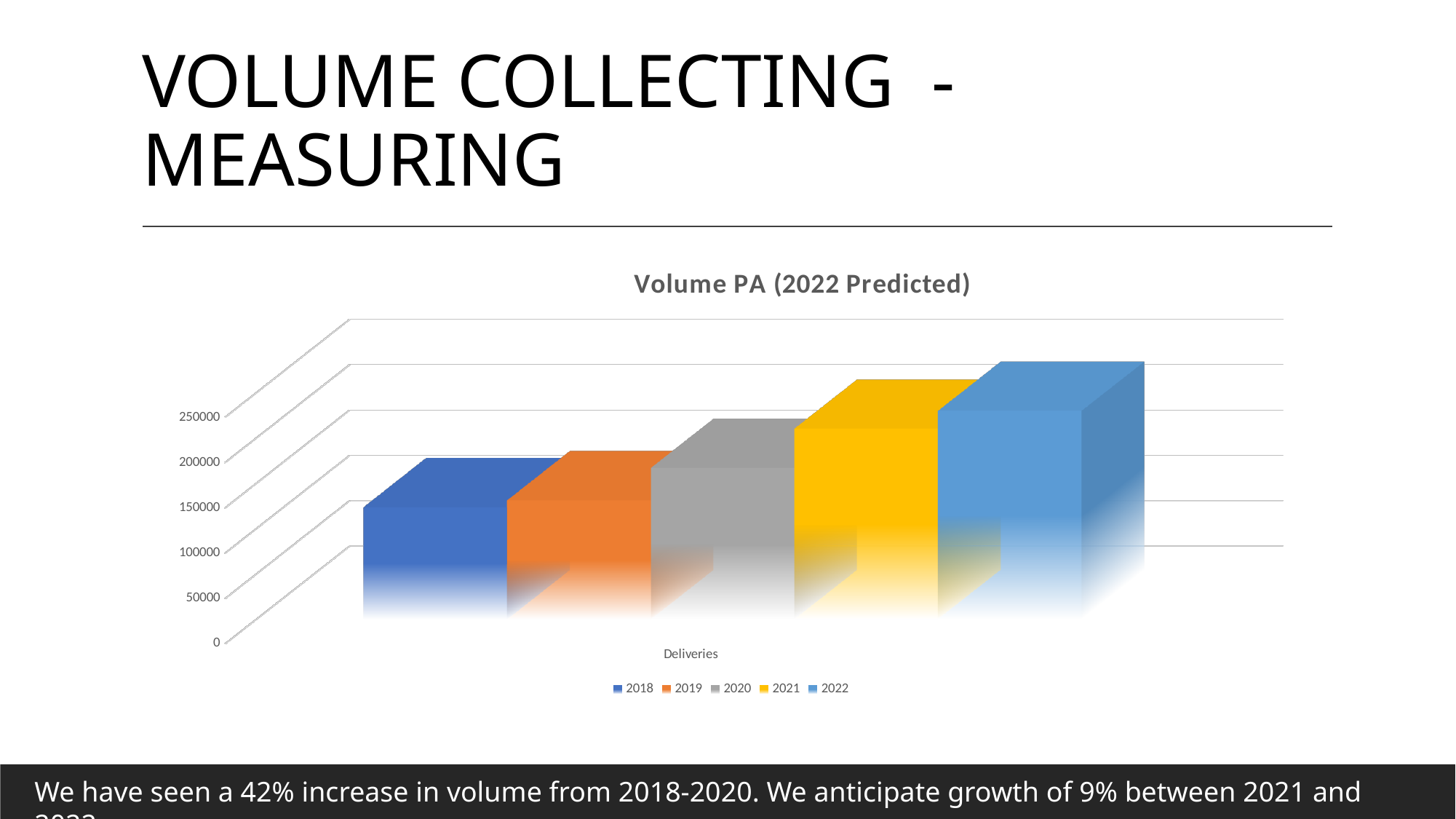
Is the value for 2022 greater or less than 150000? greater How many series does the chart legend list? 5 What is the title of the chart? Volume PA (2022 Predicted) Which year has the highest bar in the chart? 2022 What is the category label on the x axis of the chart? Deliveries What kind of chart is shown on the slide? Bar chart How many categories are shown on the x axis of the chart? 1 Is the value for 2018 greater or less than 50000? greater Do the bars rise or fall from 2018 to 2022? Rise Which year has the lowest bar in the chart? 2018 Which is larger, the bar for 2022 or the bar for 2018? 2022 Which is larger, the bar for 2021 or the bar for 2019? 2021